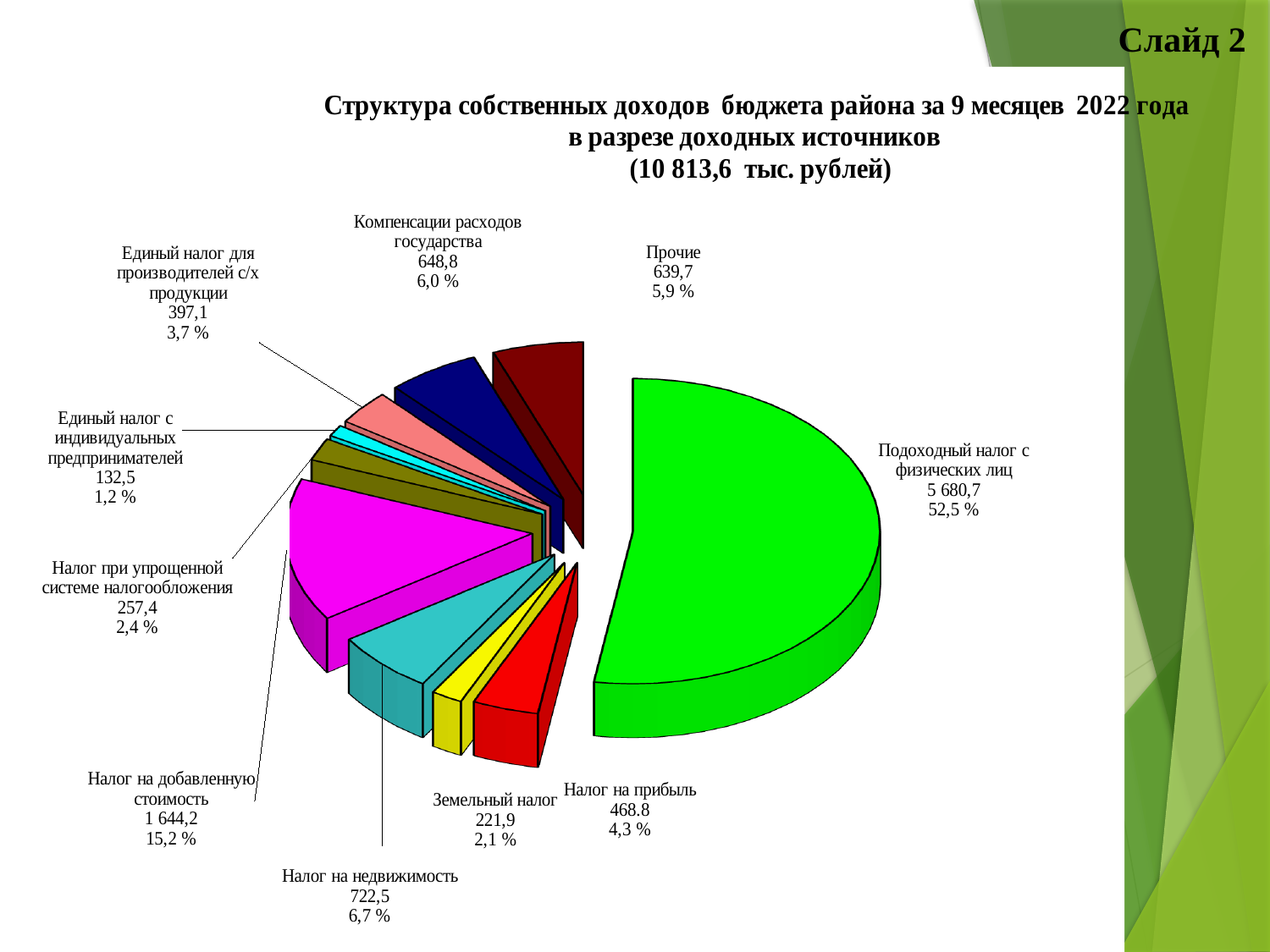
What share of the pie does Земельный налог represent? 2,1 % What total amount in тыс. рублей is stated in the chart title? 10 813,6 Which is larger, the value for Прочие or the value for Налог на прибыль? Прочие What is the value for Налог на недвижимость? 722,5 What is the value for Налог на добавленную стоимость? 1 644,2 What is the value for Подоходный налог с физических лиц? 5 680,7 How many categories (slices) does the pie chart have? 10 Which category has the smallest slice of the pie? Единый налог с индивидуальных предпринимателей What share of the pie does Компенсации расходов государства represent? 6,0 % Which category has the largest slice of the pie? Подоходный налог с физических лиц What kind of chart is shown on the slide? pie chart What is the difference between the values for Налог на добавленную стоимость and Налог на недвижимость? 921,7